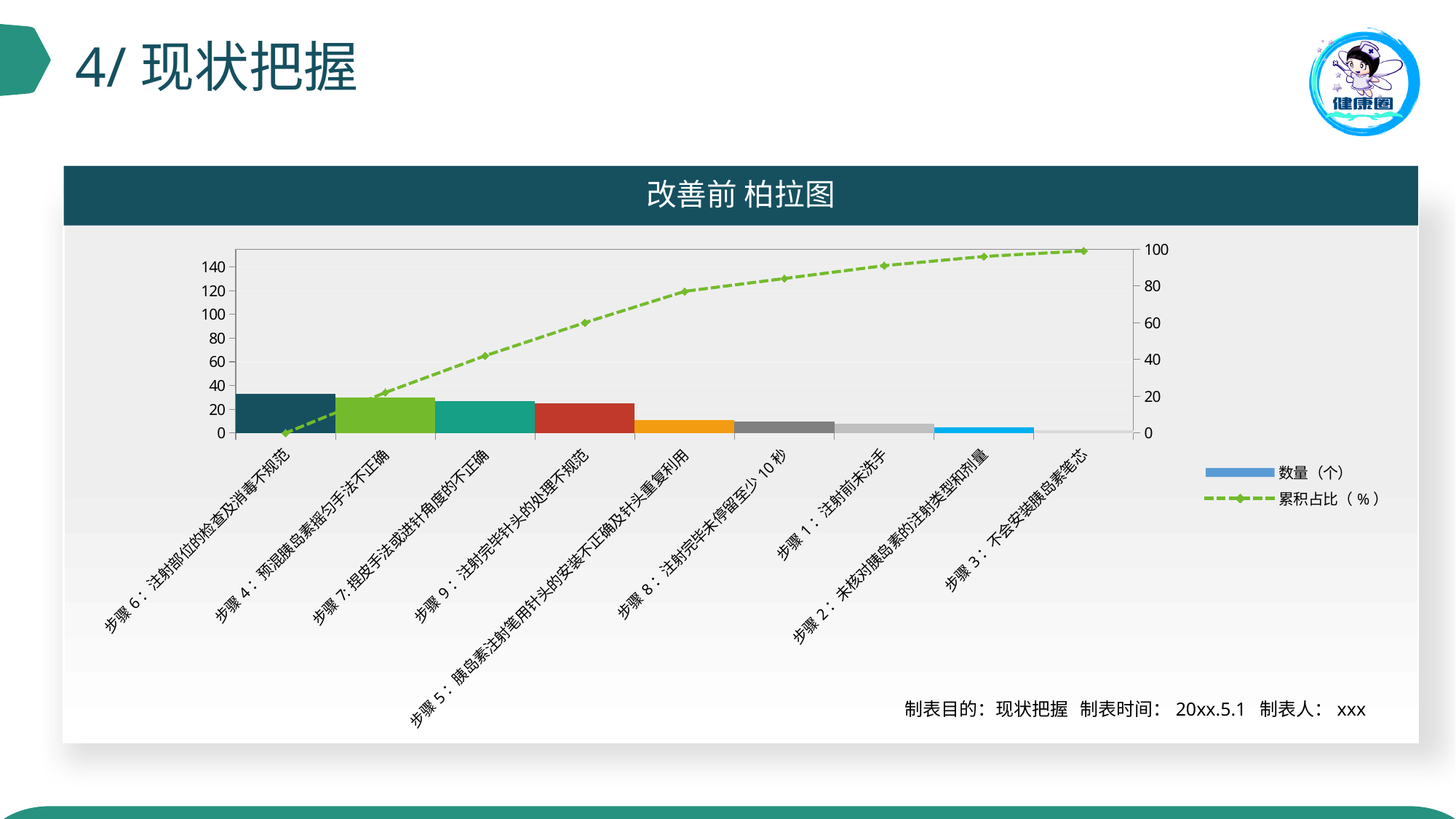
What is the title of the chart? 改善前 柏拉图 What are the two legend entries of the chart? 数量（个） and 累积占比（%） Which category has the highest bar? 步骤 6：注射部位的检查及消毒不规范 Is the bar value for 步骤 6：注射部位的检查及消毒不规范 greater or less than 20? greater Is the bar value for 步骤 5：胰岛素注射笔用针头的安装不正确及针头重复利用 greater or less than 20? less How many series does the legend list? 2 Which bar is larger: 步骤 4：预混胰岛素摇匀手法不正确 or 步骤 8：注射完毕未停留至少 10 秒? 步骤 4：预混胰岛素摇匀手法不正确 What kind of chart is shown on the slide? A bar chart with a line Do the bar values rise or fall from left to right along the x axis? fall How many categories (steps) are plotted on the x axis? 9 Which category has the lowest bar? 步骤 3：不会安装胰岛素笔芯